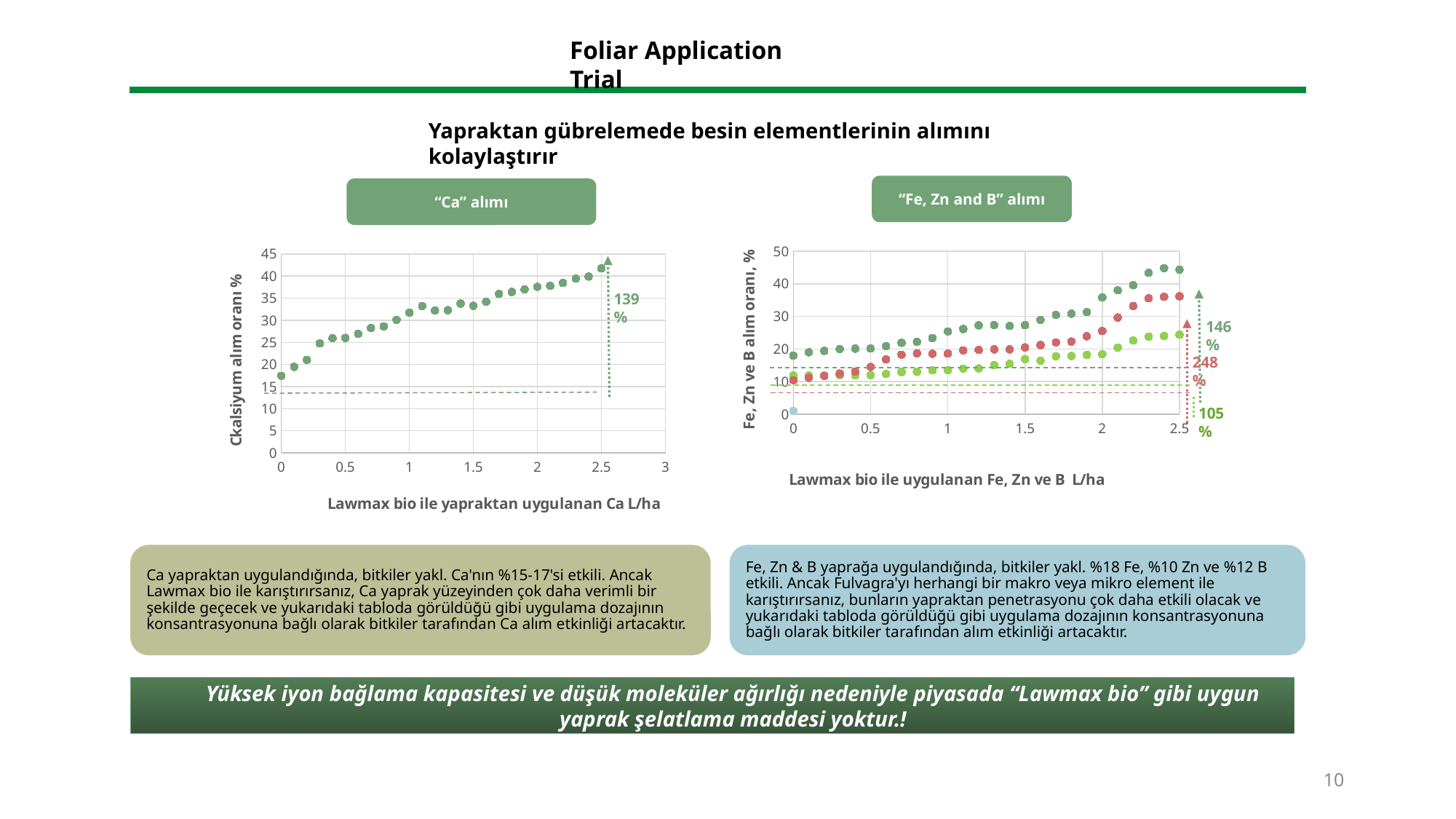
What is the highest tick value shown on the y axis of the "Fe, Zn and B" alımı chart on the right? 50 In the "Ca" alımı chart on the left, is the value at 2.5 L/ha greater or less than 35? greater In the "Ca" alımı chart on the left, do the values rise or fall as the applied Ca dose increases along the x axis? rise What is the percentage annotation printed next to the arrow in the "Ca" alımı chart on the left? 139% What is the x-axis title of the "Ca" alımı chart on the left? Lawmax bio ile yapraktan uygulanan Ca L/ha In the "Fe, Zn and B" alımı chart on the right, is the dark green series value at 2.5 L/ha greater or less than 40? greater In the "Fe, Zn and B" alımı chart on the right, which series has the highest value at 2.5 L/ha: the dark green, red, or light green series? dark green In the "Fe, Zn and B" alımı chart on the right, is the red series value at 2.5 L/ha greater or less than 30? greater In the "Fe, Zn and B" alımı chart on the right, do the dark green series values rise or fall along the x axis? rise What kind of chart is the "Ca" alımı chart on the left? scatter chart